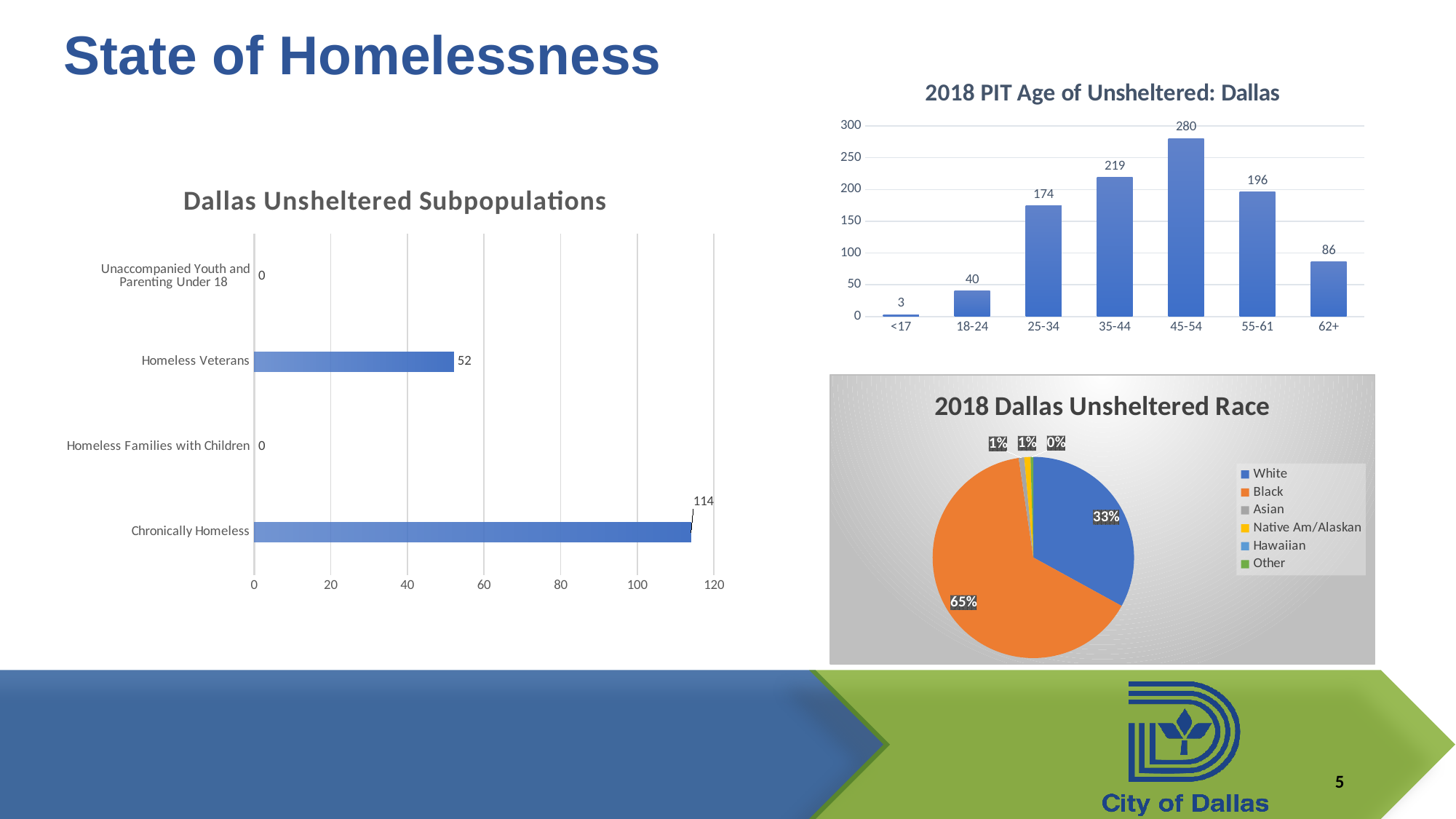
In the '2018 PIT Age of Unsheltered: Dallas' chart, which is larger, 55-61 or 62+? 55-61 In the '2018 PIT Age of Unsheltered: Dallas' chart, what is the difference between the 35-44 and 25-34 age groups? 45 In the 'Dallas Unsheltered Subpopulations' chart, what is the value for Chronically Homeless? 114 How many entries does the legend of the '2018 Dallas Unsheltered Race' chart list? 6 In the '2018 PIT Age of Unsheltered: Dallas' chart, what is the value for the 45-54 age group? 280 In the '2018 PIT Age of Unsheltered: Dallas' chart, which age group has the lowest value? <17 In the 'Dallas Unsheltered Subpopulations' chart, what is the value for Homeless Veterans? 52 In the 'Dallas Unsheltered Subpopulations' chart, how many categories are shown? 4 In the '2018 Dallas Unsheltered Race' pie chart, what share is Black? 65% In the 'Dallas Unsheltered Subpopulations' chart, what is the difference between Chronically Homeless and Homeless Veterans? 62 In the 'Dallas Unsheltered Subpopulations' chart, which category has the highest value? Chronically Homeless What kind of chart is 'Dallas Unsheltered Subpopulations'? Bar chart